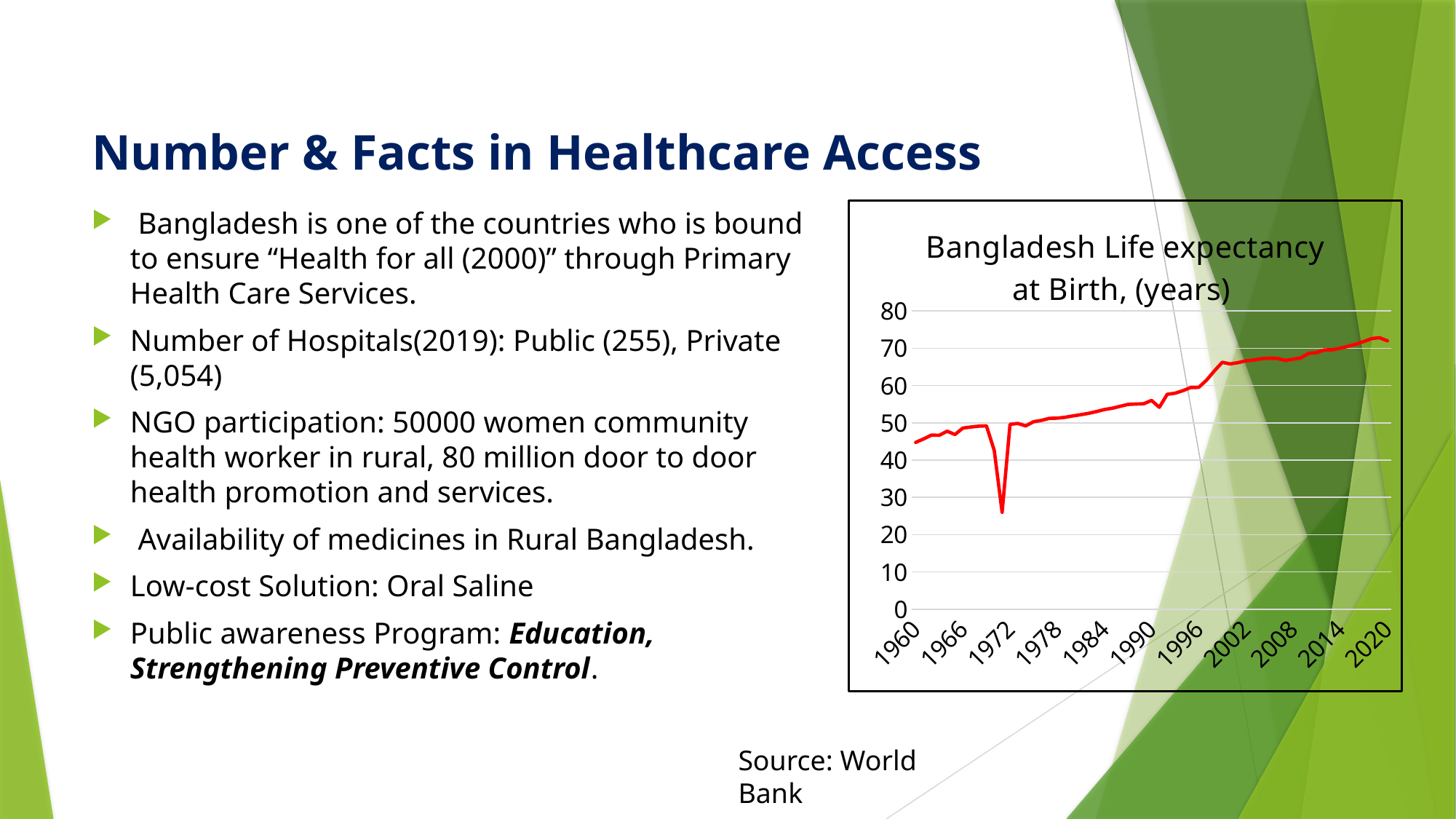
Is the value for 2020 greater or less than 70? greater Is the value for 1960 greater or less than 50? less Overall, do the values in the chart rise or fall from 1960 to 2020? rise What kind of chart is shown on the slide? line chart Is the value for 1990 greater or less than 50? greater Which year has the larger value, 1978 or 2002? 2002 How many year labels are shown on the x axis? 11 What is the source cited for the chart data? World Bank What is the title of the chart? Bangladesh Life expectancy at Birth, (years)